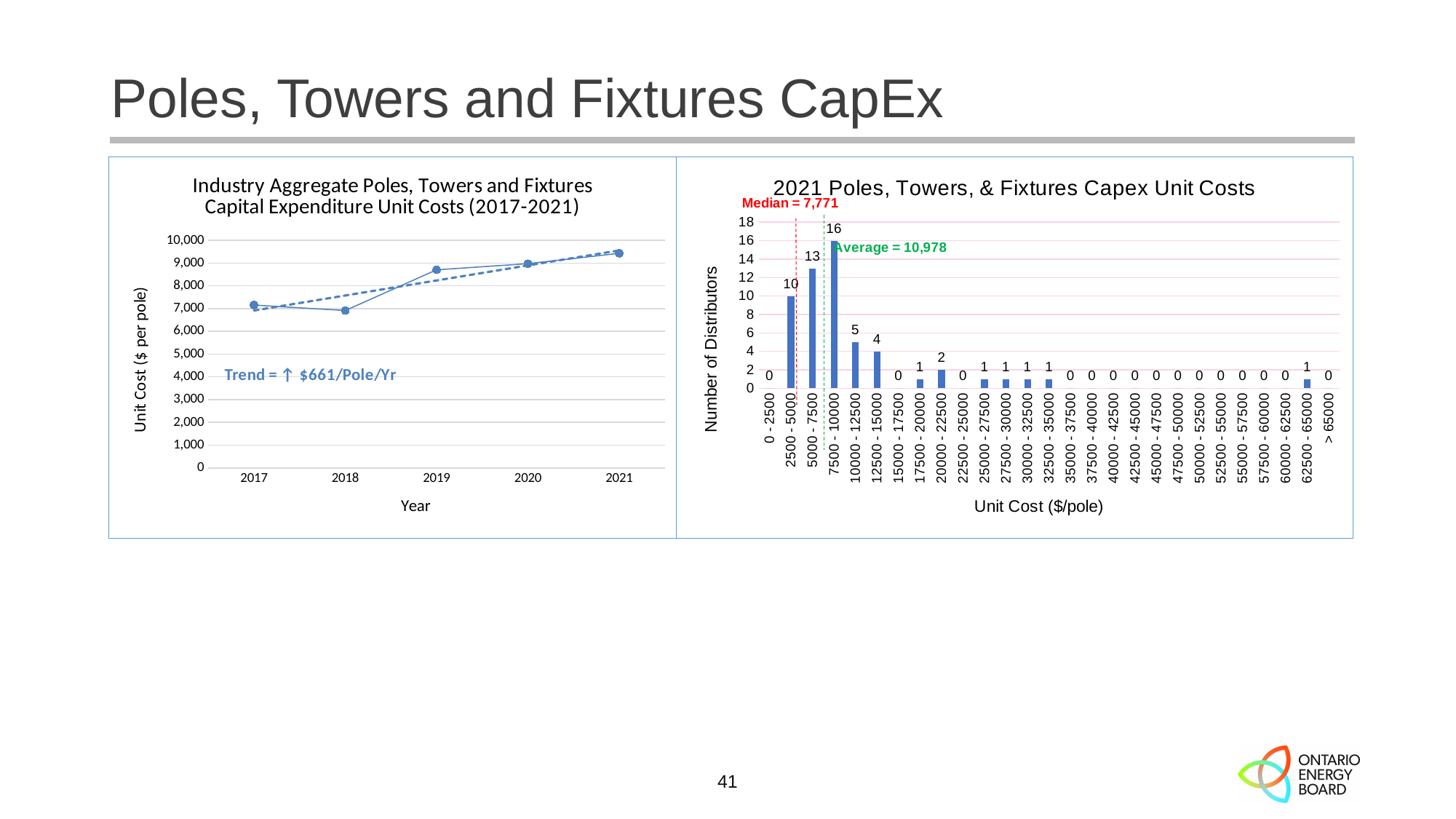
In the left chart, which year has the lowest unit cost? 2018 What type of chart is the left chart, 'Industry Aggregate Poles, Towers and Fixtures Capital Expenditure Unit Costs (2017-2021)'? line chart In the right chart, what is the difference between the number of distributors in the 5000 - 7500 bin and the 2500 - 5000 bin? 3 In the left chart, is the unit cost for 2021 greater or less than 9,000? greater In the right chart, what median value is annotated? Median = 7,771 In the left chart, do unit costs generally rise or fall from 2017 to 2021? rise In the right chart, '2021 Poles, Towers, & Fixtures Capex Unit Costs', how many distributors are in the 7500 - 10000 bin? 16 In the right chart, which has more distributors: the 10000 - 12500 bin or the 12500 - 15000 bin? 10000 - 12500 In the left chart, what trend value is annotated on the plot? ↑ $661/Pole/Yr In the left chart, which year has the highest unit cost? 2021 In the right chart, which unit cost bin has the most distributors? 7500 - 10000 In the left chart, is the unit cost for 2019 greater or less than 8,000? greater